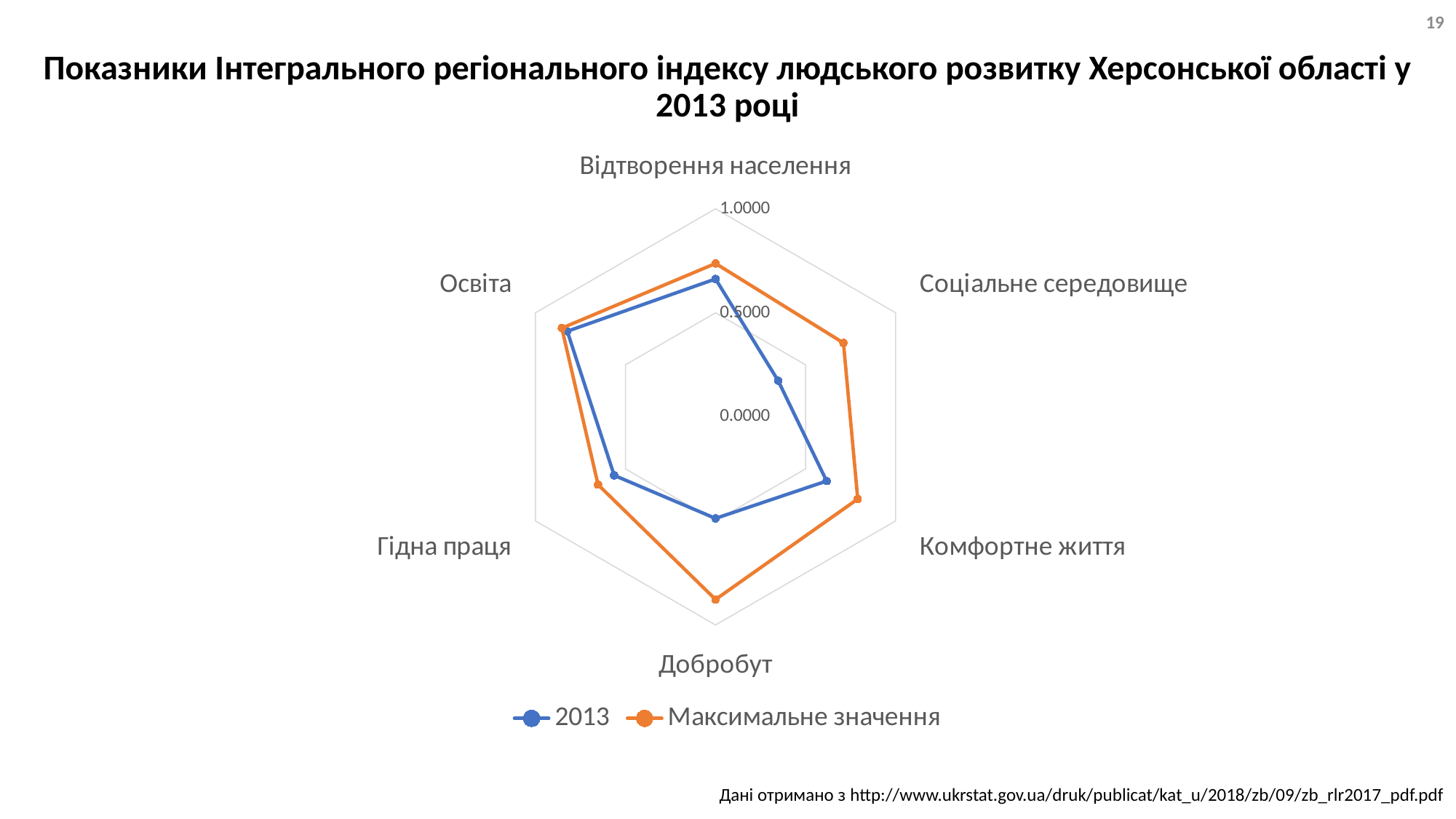
Is the Максимальне значення value for Добробут greater or less than 0.5000? greater What are the two series named in the legend? 2013 and Максимальне значення Is the Максимальне значення value for Соціальне середовище greater or less than 0.5000? greater Is the 2013 value for Відтворення населення greater or less than 0.5000? greater What is the highest value shown on the radar chart's axis scale? 1.0000 For Соціальне середовище, which series has the larger value, 2013 or Максимальне значення? Максимальне значення What kind of chart is shown on the slide? radar chart Which category has the lowest value for the 2013 series? Соціальне середовище How many categories (axes) does the radar chart have? 6 How many series does the legend list? 2